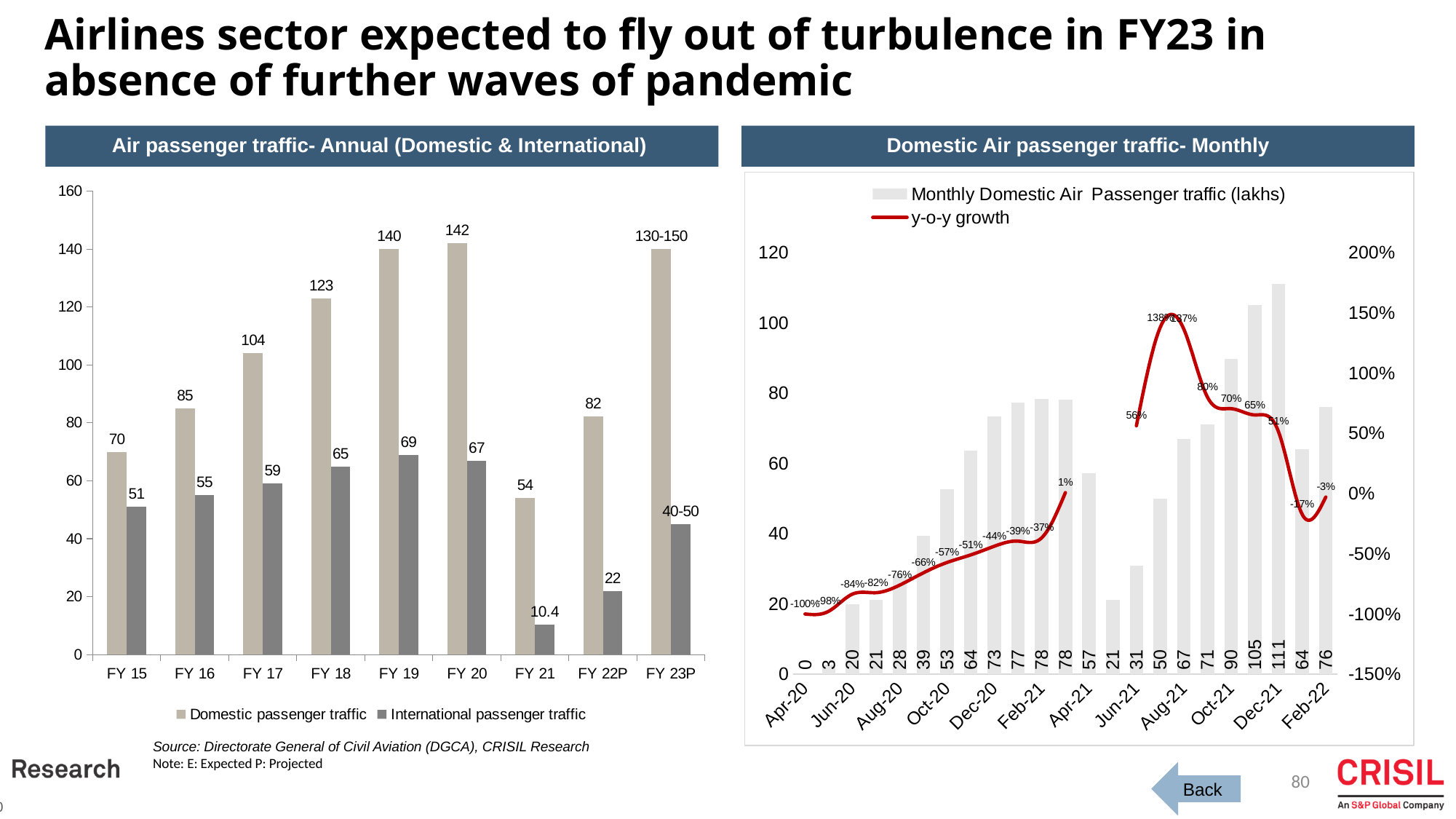
How many fiscal years are shown on the x axis of the 'Air passenger traffic- Annual (Domestic & International)' chart? 9 In the 'Domestic Air passenger traffic- Monthly' chart, what is the y-o-y growth shown for Feb-22? -3% What type of chart is the 'Air passenger traffic- Annual (Domestic & International)' chart? Bar chart In the 'Domestic Air passenger traffic- Monthly' chart, what is the monthly domestic air passenger traffic (lakhs) for Dec-21? 111 In the 'Air passenger traffic- Annual (Domestic & International)' chart, what is the international passenger traffic for FY 21? 10.4 In the 'Air passenger traffic- Annual (Domestic & International)' chart, what is the domestic passenger traffic for FY 19? 140 In the 'Domestic Air passenger traffic- Monthly' chart, which month has the highest monthly domestic air passenger traffic? Dec-21 In the 'Air passenger traffic- Annual (Domestic & International)' chart, which is larger in FY 18: domestic or international passenger traffic? Domestic passenger traffic In the 'Air passenger traffic- Annual (Domestic & International)' chart, what is the projected domestic passenger traffic for FY 23P? 130-150 In the 'Air passenger traffic- Annual (Domestic & International)' chart, what is the difference between domestic passenger traffic in FY 20 and FY 21? 88 In the 'Air passenger traffic- Annual (Domestic & International)' chart, which fiscal year has the lowest international passenger traffic? FY 21 How many series does the legend of the 'Air passenger traffic- Annual (Domestic & International)' chart list? 2